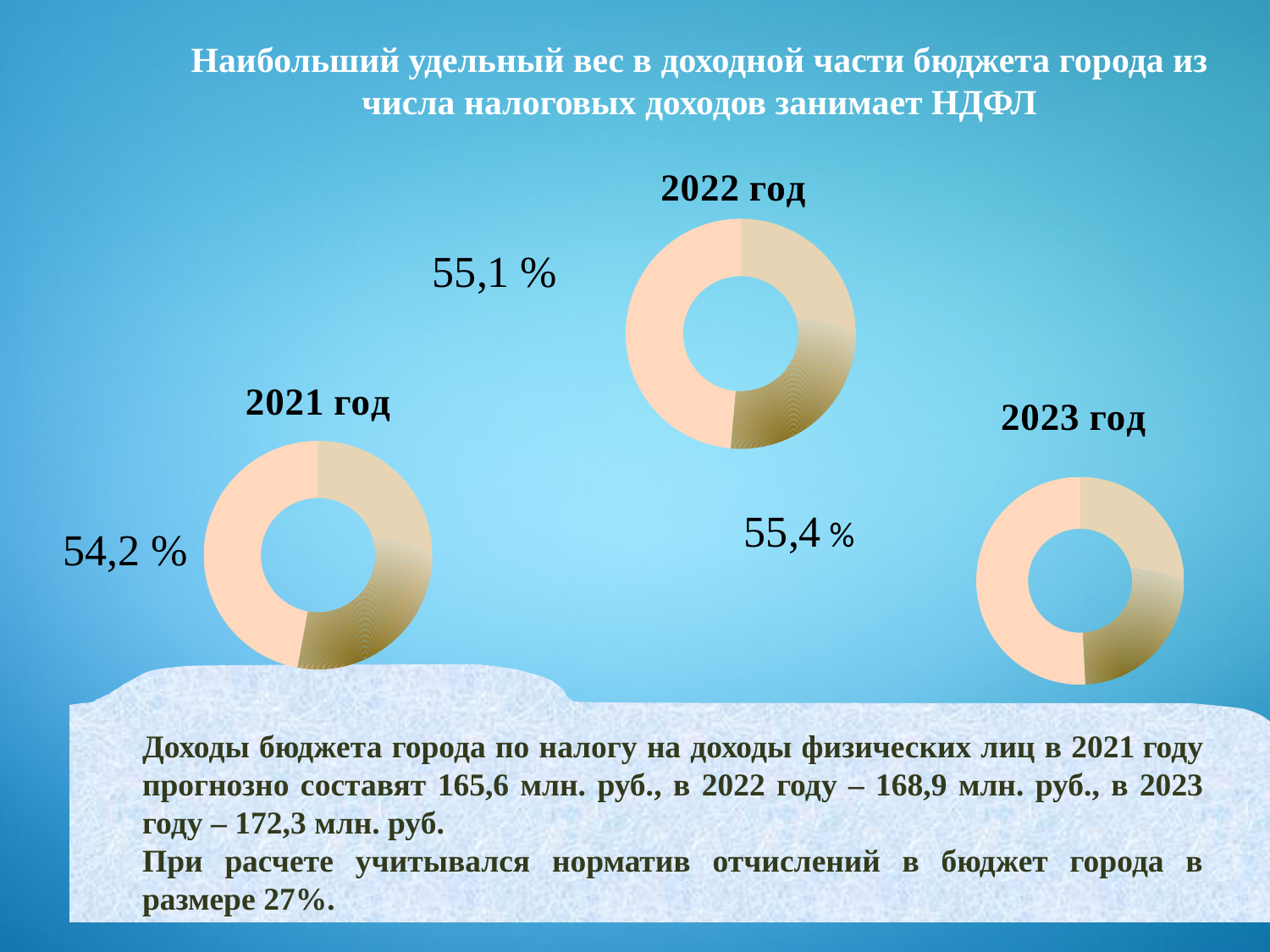
Which year's chart is placed highest on the slide? 2022 год What type of chart is used to show the НДФЛ share for each year? Doughnut (pie) chart Which year's chart shows the highest share of НДФЛ? 2023 год What share does the 2023 год doughnut chart show for НДФЛ? 55,4 % What share does the 2022 год doughnut chart show for НДФЛ? 55,1 % Which is larger: the share shown for 2022 год or for 2023 год? 2023 год How many doughnut charts are shown on the slide? 3 By how many percentage points does the share shown for 2022 год exceed the share shown for 2021 год? 0,9 Does the share of НДФЛ rise or fall from 2021 год to 2023 год? Rises By how many percentage points does the share shown for 2023 год exceed the share shown for 2021 год? 1,2 Which year's chart shows the lowest share of НДФЛ? 2021 год What share does the 2021 год doughnut chart show for НДФЛ? 54,2 %